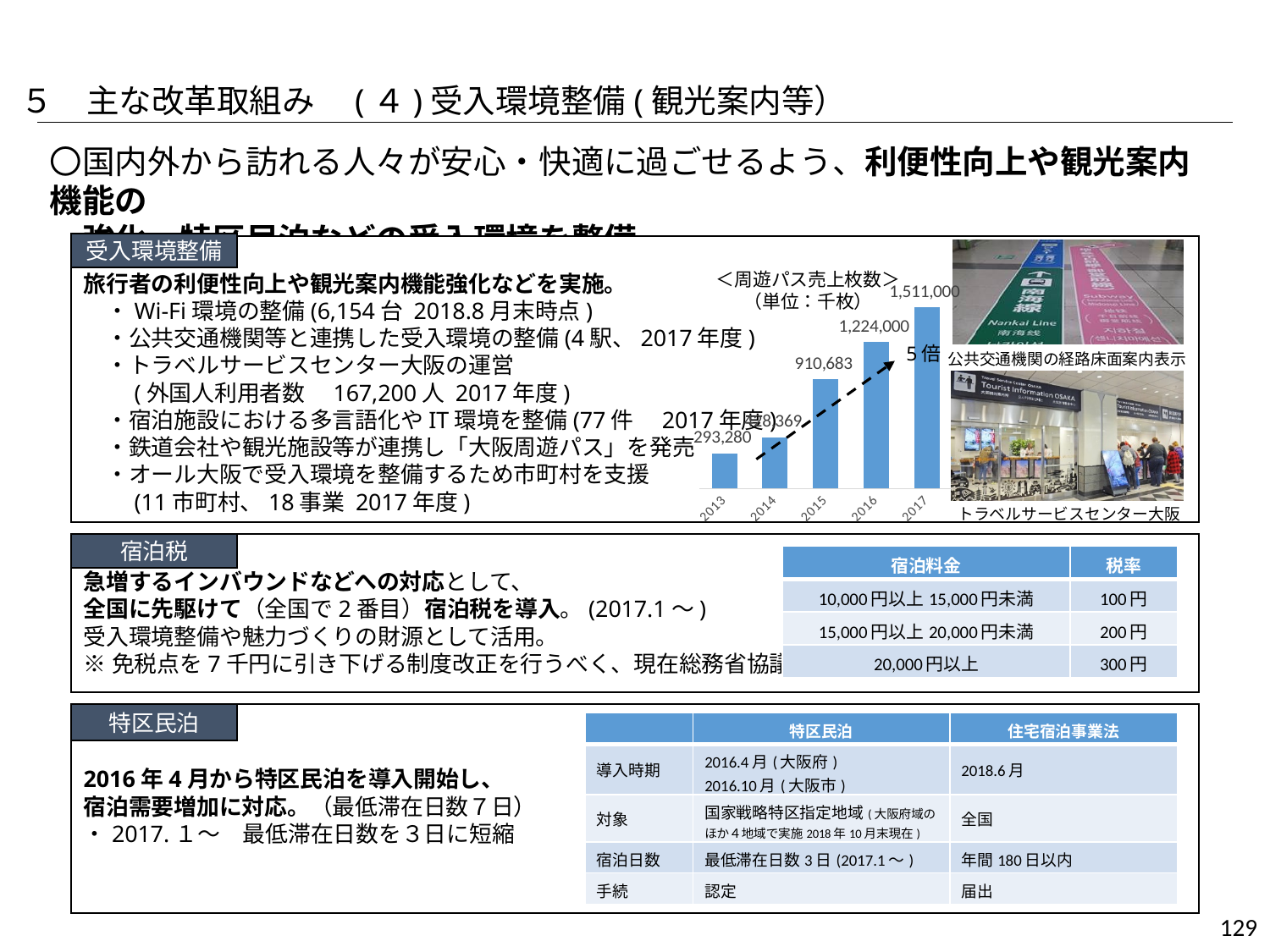
Which year has the highest value in the 周遊パス売上枚数 chart? 2017 In the 周遊パス売上枚数 chart, what is the difference between the 2017 and 2016 values? 287,000 In the 周遊パス売上枚数 chart, which is larger, the value for 2015 or the value for 2013? 2015 In the 周遊パス売上枚数 chart, what is the difference between the 2016 and 2015 values? 313,317 Do the values in the 周遊パス売上枚数 chart rise or fall from 2013 to 2017? Rise What is the value for 2017 in the 周遊パス売上枚数 chart? 1,511,000 What is the value for 2015 in the 周遊パス売上枚数 chart? 910,683 How many years are shown in the 周遊パス売上枚数 chart? 5 What is the value for 2016 in the 周遊パス売上枚数 chart? 1,224,000 What is the value for 2013 in the 周遊パス売上枚数 chart? 293,280 What kind of chart is the 周遊パス売上枚数 chart? Bar chart Which year has the lowest value in the 周遊パス売上枚数 chart? 2013